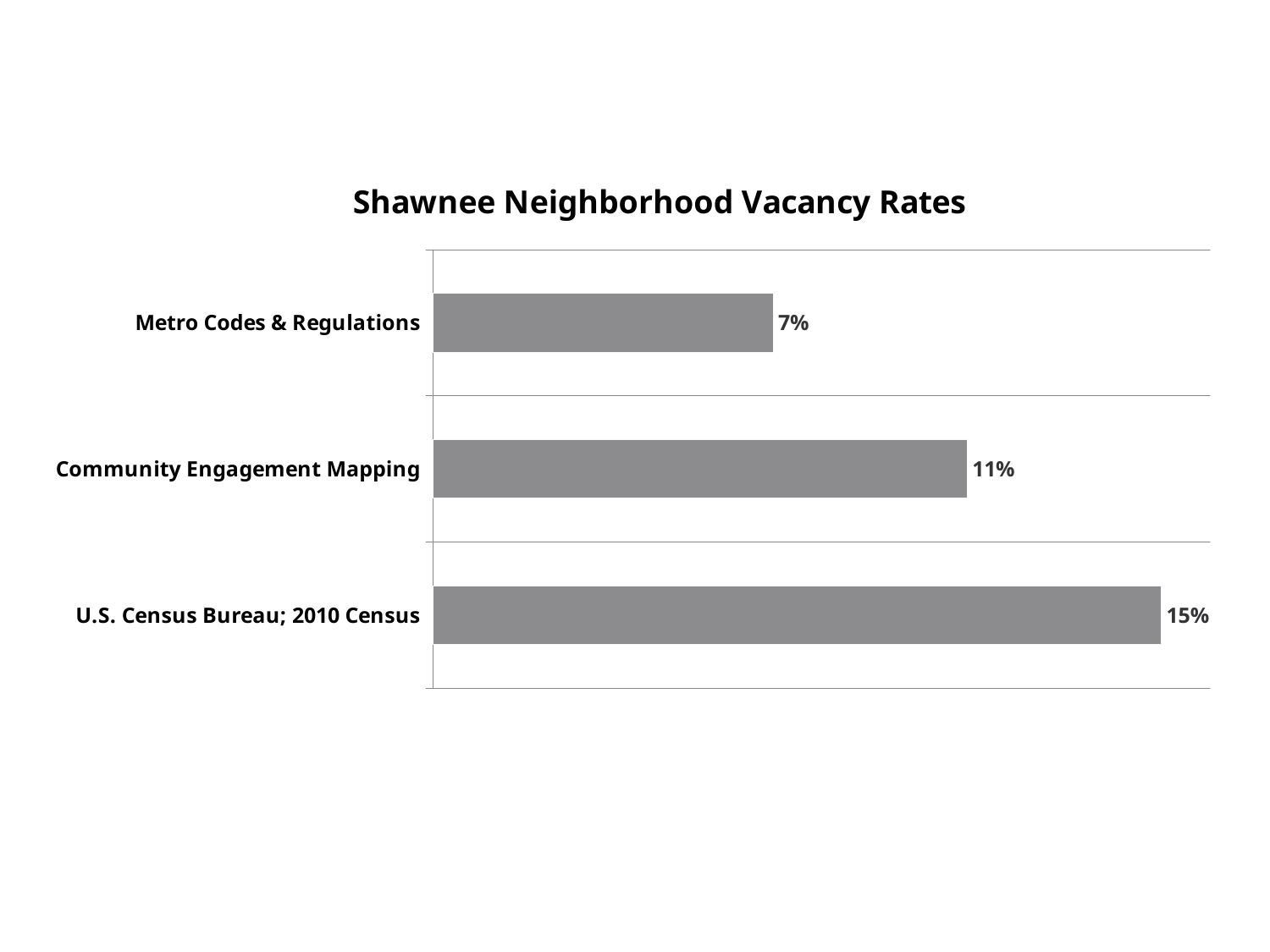
What is the vacancy rate according to the U.S. Census Bureau; 2010 Census? 15% Which source reports the highest vacancy rate? U.S. Census Bureau; 2010 Census How many sources are shown in the chart? 3 Which is larger, the vacancy rate from Community Engagement Mapping or from Metro Codes & Regulations? Community Engagement Mapping What is the difference between the U.S. Census Bureau; 2010 Census vacancy rate and the Metro Codes & Regulations vacancy rate? 8% What is the title of the chart? Shawnee Neighborhood Vacancy Rates Which source reports the lowest vacancy rate? Metro Codes & Regulations What is the vacancy rate according to Community Engagement Mapping? 11% What is the difference between the Community Engagement Mapping vacancy rate and the Metro Codes & Regulations vacancy rate? 4% What colour are the bars in the chart? Gray What kind of chart is shown on the slide? Bar chart What is the vacancy rate according to Metro Codes & Regulations? 7%